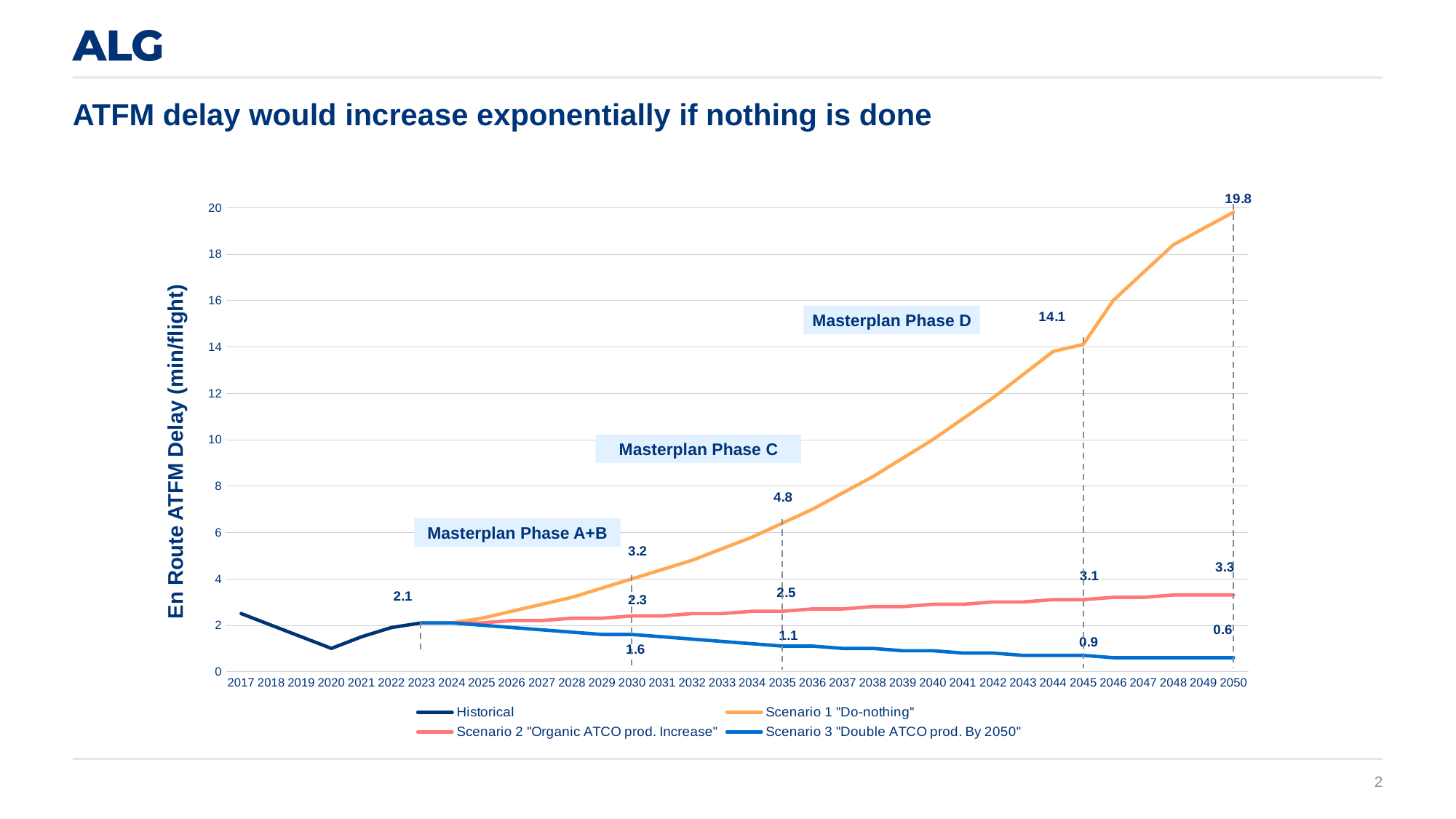
What is the value for Scenario 2 "Organic ATCO prod. Increase" in 2045? 3.1 By how much does Scenario 1 "Do-nothing" increase between 2045 and 2050? 5.7 Which series has the highest value in 2050? Scenario 1 "Do-nothing" How many series does the legend list? 4 What is the difference between Scenario 1 "Do-nothing" and Scenario 2 "Organic ATCO prod. Increase" in 2050? 16.5 What kind of chart is shown on the slide? Line chart In 2050, which is larger: Scenario 2 "Organic ATCO prod. Increase" or Scenario 3 "Double ATCO prod. By 2050"? Scenario 2 "Organic ATCO prod. Increase" Is the value for Scenario 1 "Do-nothing" in 2040 greater or less than 8? greater What is the value for Scenario 3 "Double ATCO prod. By 2050" in 2050? 0.6 Does Scenario 3 "Double ATCO prod. By 2050" rise or fall from 2024 to 2050? Fall What is the labelled value of the Historical series in 2023? 2.1 What is the value for Scenario 1 "Do-nothing" in 2050? 19.8